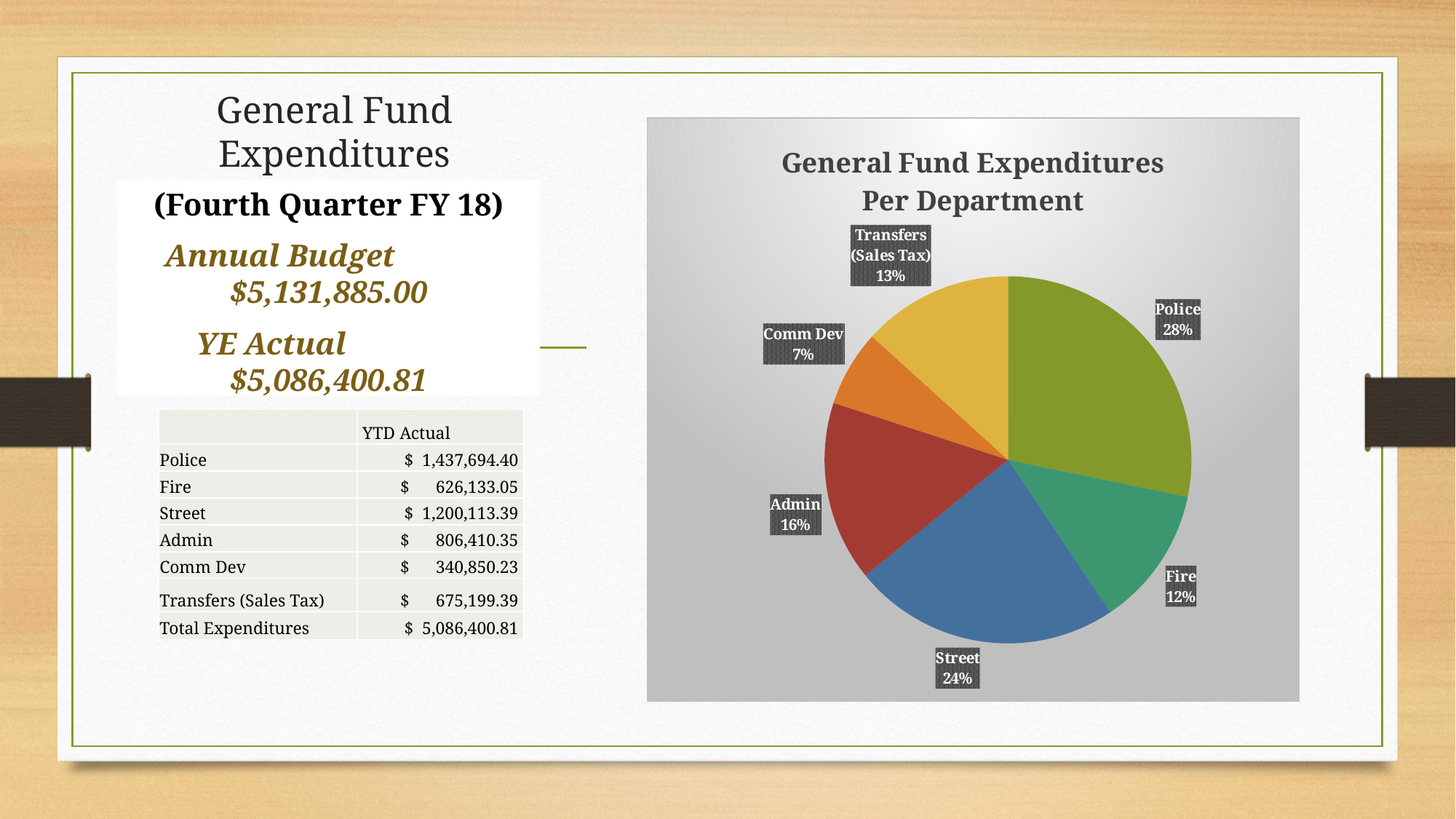
What share of the pie does Street represent? 24% What share of the pie does Transfers (Sales Tax) represent? 13% What colour is the Street slice? blue Which department has the largest slice of the pie? Police How many slices does the pie chart have? 6 What share of the pie does Admin represent? 16% Which department has the smallest slice of the pie? Comm Dev What is the difference in percentage points between the Police and Fire slices? 16% Which slice is larger, Admin or Fire? Admin What is the title of the chart? General Fund Expenditures Per Department What type of chart is shown on the slide? pie chart